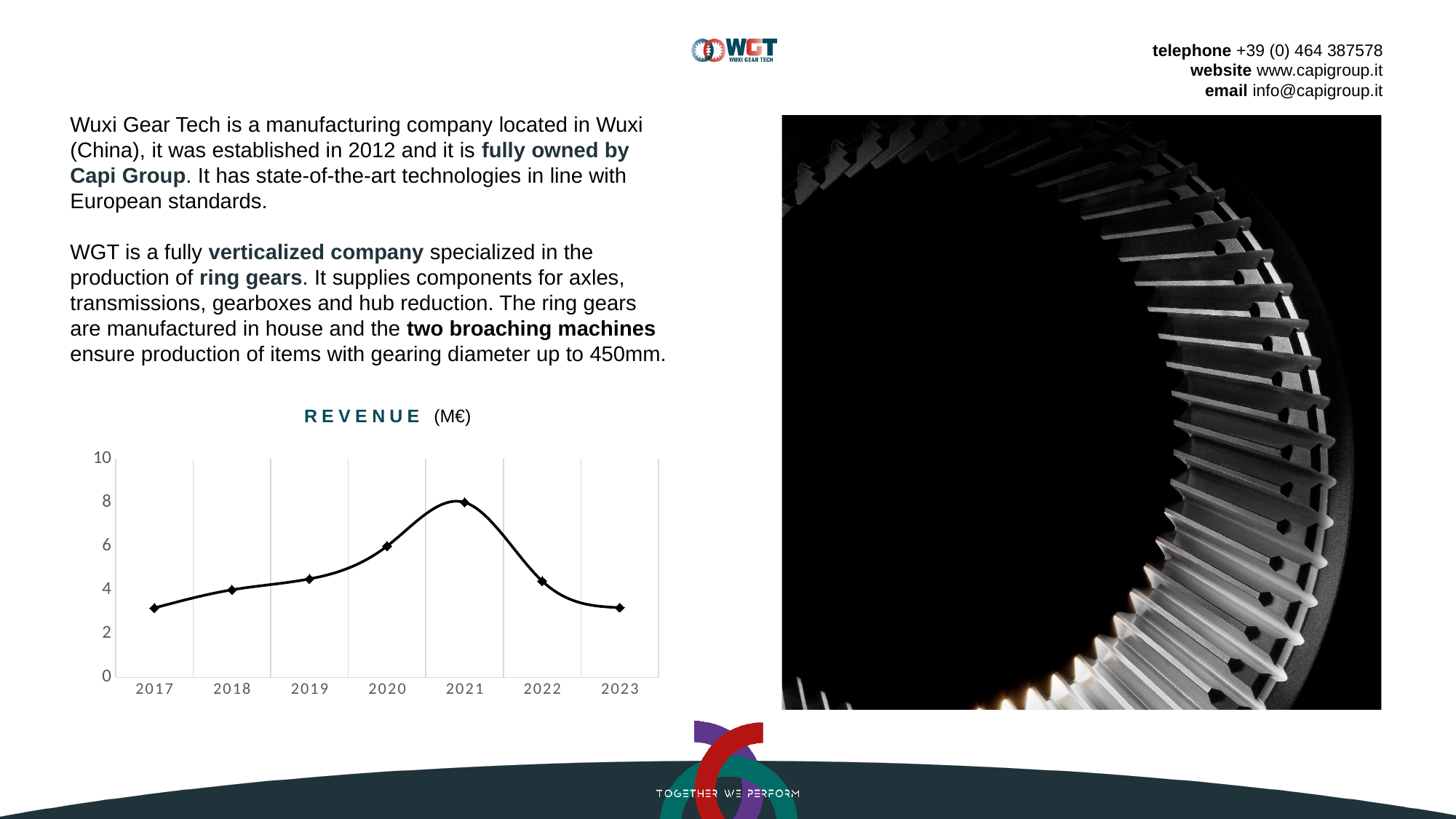
Which year has the highest revenue? 2021 Which year has higher revenue, 2020 or 2022? 2020 Is the revenue for 2021 greater or less than 6? greater Is the revenue for 2017 greater or less than 4? less Does revenue rise or fall from 2017 to 2021? rise Is the revenue for 2020 greater or less than 4? greater What is the title of the chart? REVENUE (M€) Does revenue rise or fall from 2021 to 2023? fall What kind of chart is shown on the slide? line chart How many years are plotted on the revenue chart? 7 In what unit is revenue shown on the chart? M€